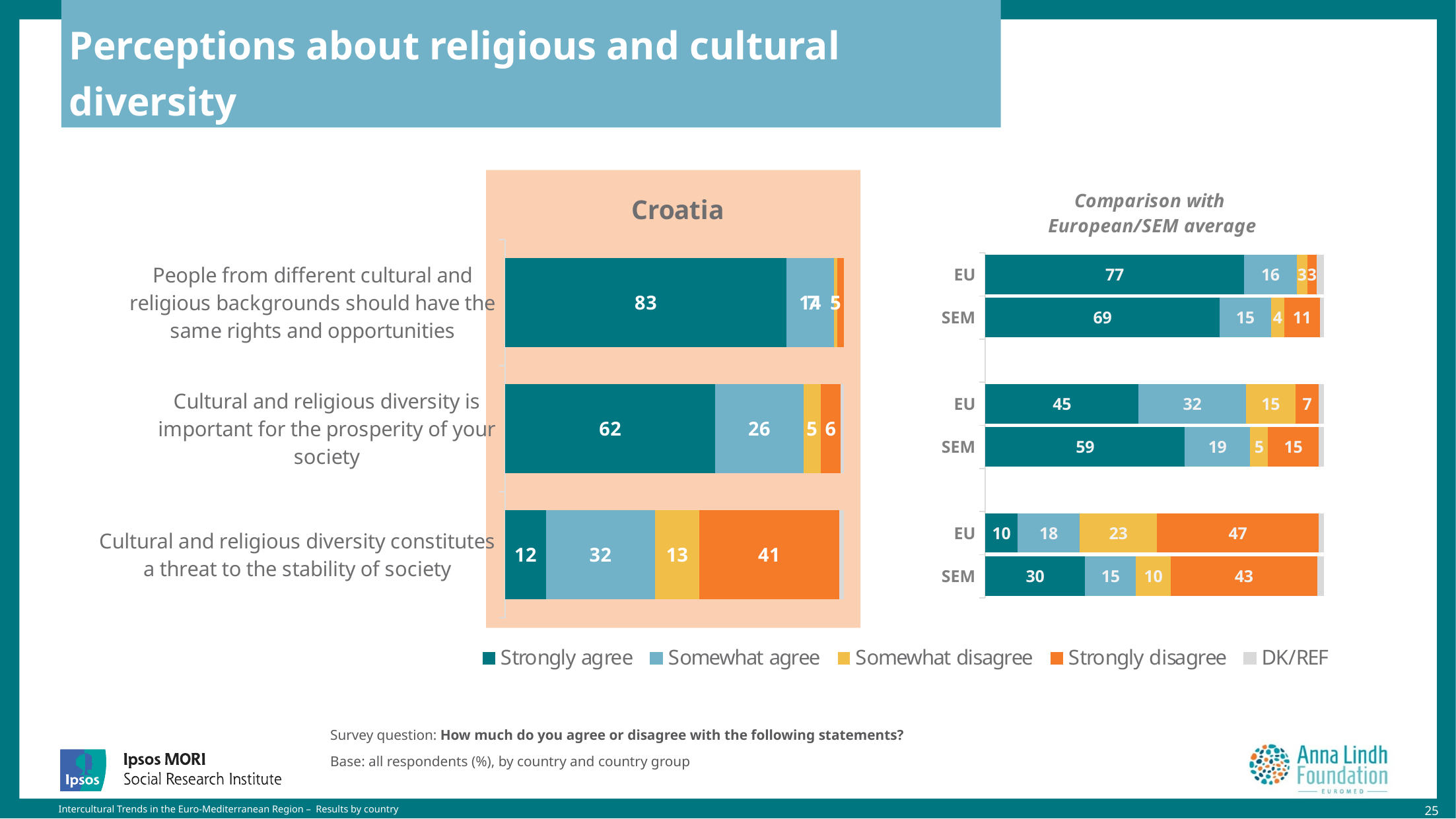
In the Croatia chart, what is the difference between the 'Strongly disagree' and 'Strongly agree' values for the statement that diversity constitutes a threat to the stability of society? 29 In the Comparison with European/SEM average chart, which has the larger 'Strongly agree' value for the statement that diversity is important for prosperity, EU or SEM? SEM In the Croatia chart, which statement has the highest 'Strongly agree' value? People from different cultural and religious backgrounds should have the same rights and opportunities In the Comparison with European/SEM average chart, what is the EU 'Strongly agree' value for the statement about same rights and opportunities? 77 How many statements are shown in the Croatia chart? 3 How many series does the legend list? 5 In the Comparison with European/SEM average chart, what is the EU 'Somewhat disagree' value for the statement that diversity constitutes a threat to the stability of society? 23 In the Croatia chart, what percentage strongly disagree that cultural and religious diversity constitutes a threat to the stability of society? 41 In the Comparison with European/SEM average chart, what is the SEM 'Strongly disagree' value for the statement that diversity constitutes a threat to the stability of society? 43 In the Croatia chart, what percentage strongly agree that people from different cultural and religious backgrounds should have the same rights and opportunities? 83 What kind of chart is the Croatia chart? Stacked bar chart In the Croatia chart, what percentage somewhat agree that cultural and religious diversity is important for the prosperity of your society? 26